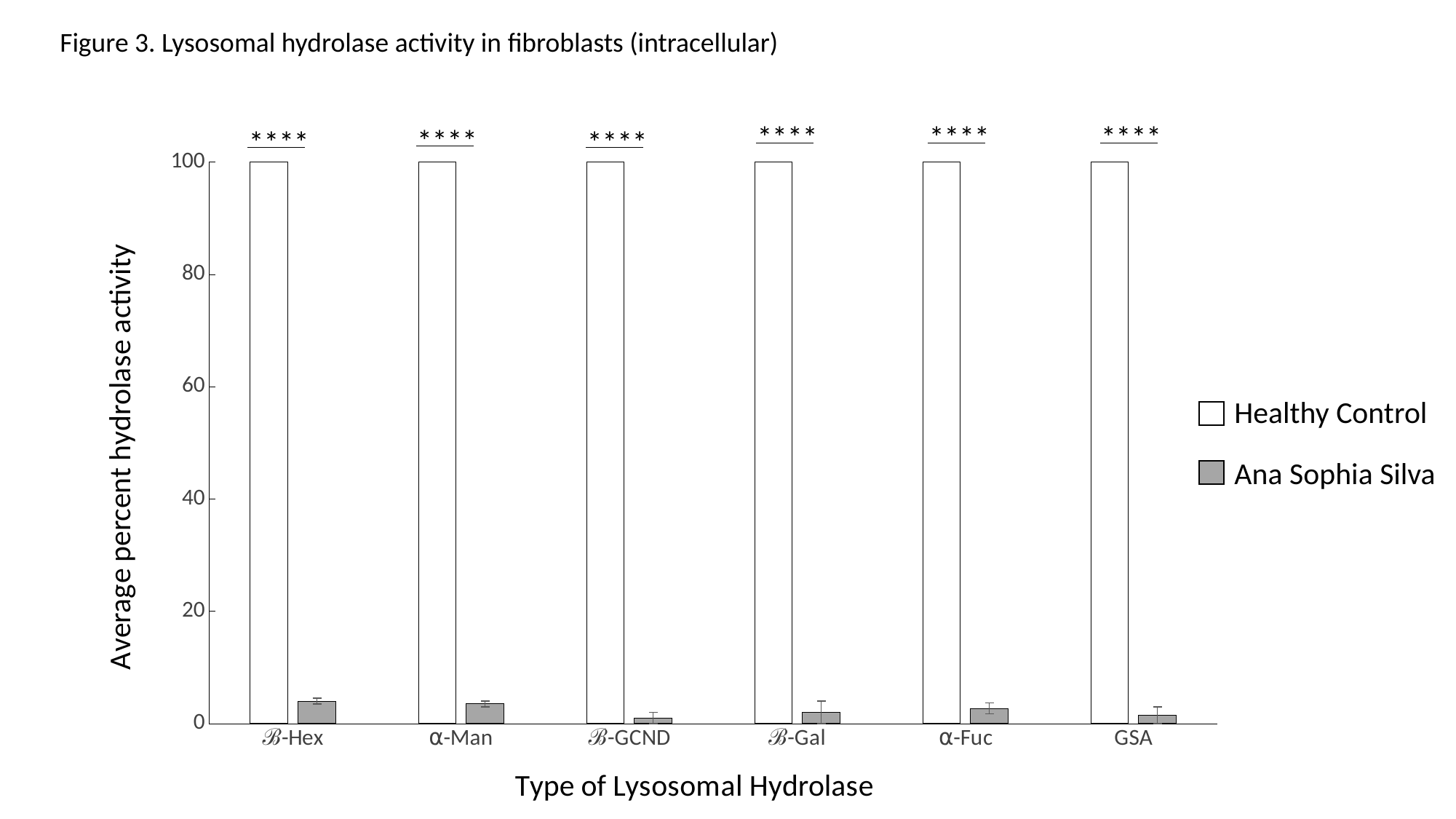
What is the label of the x axis? Type of Lysosomal Hydrolase For β-Gal, which series has the larger value, Healthy Control or Ana Sophia Silva? Healthy Control What kind of chart is shown on the slide? Bar chart Is the value for Ana Sophia Silva for β-Hex greater or less than 20? less How many series does the legend list? 2 What is the average percent hydrolase activity for Healthy Control for β-Hex? 100 What is the title of the figure? Figure 3. Lysosomal hydrolase activity in fibroblasts (intracellular) How many types of lysosomal hydrolase are shown on the x axis? 6 What is the average percent hydrolase activity for Healthy Control for GSA? 100 Is the value for Healthy Control for α-Man greater or less than 80? greater Which series has the lower values across all hydrolase types? Ana Sophia Silva Is the value for Ana Sophia Silva for α-Fuc greater or less than 20? less